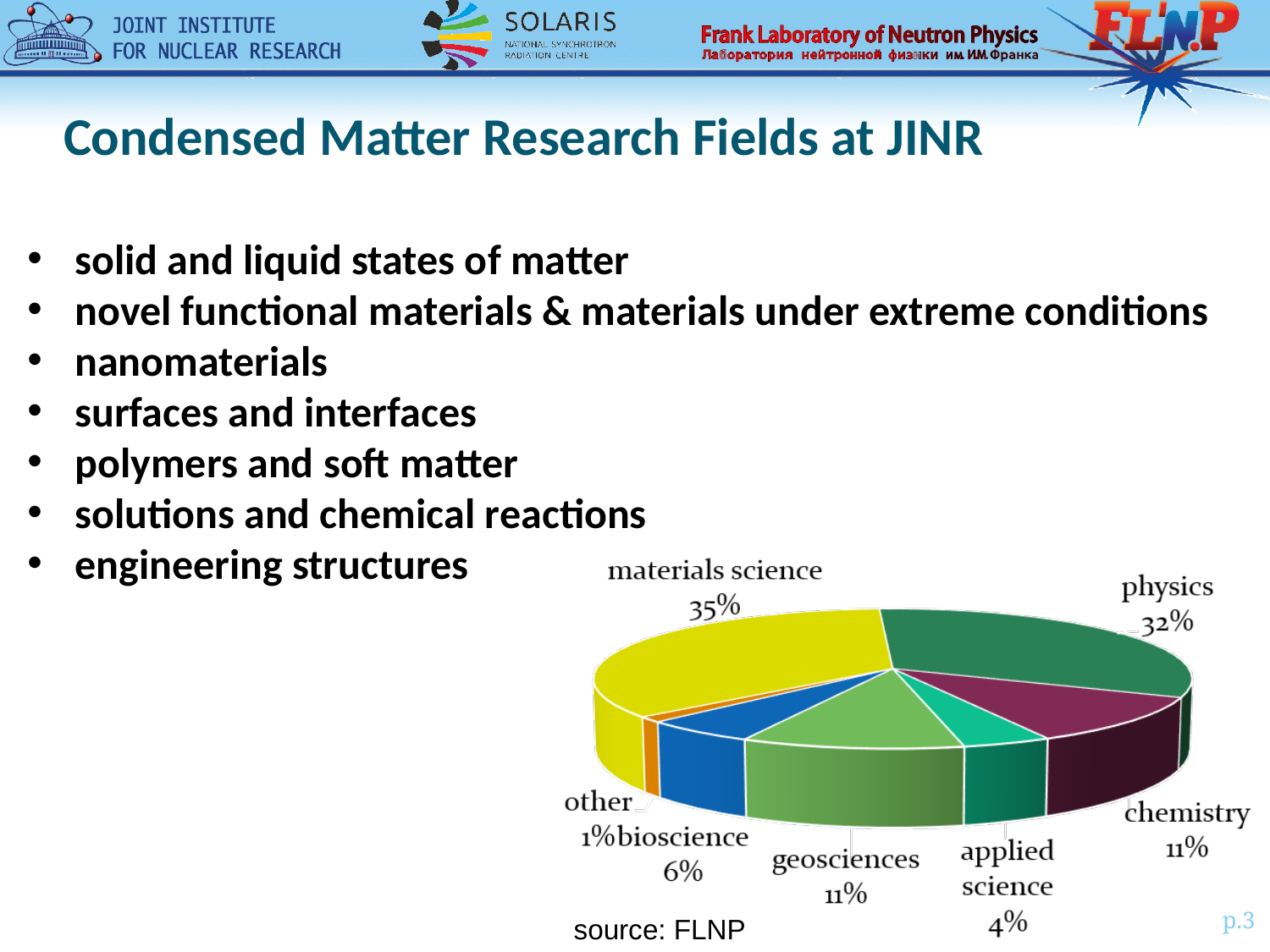
What is the combined share of chemistry and geosciences? 22% Which is larger, the share for bioscience or the share for applied science? bioscience What percentage is shown for the 'other' slice? 1% Which category has the largest share of the pie? materials science Which category has the smallest share of the pie? other What is the difference in percentage points between materials science and physics? 3 What kind of chart is shown on the slide? pie chart What percentage is shown for bioscience? 6% What share of the pie does materials science have? 35% How many slices does the pie chart have? 7 What share of the pie does physics have? 32% What percentage is shown for applied science? 4%